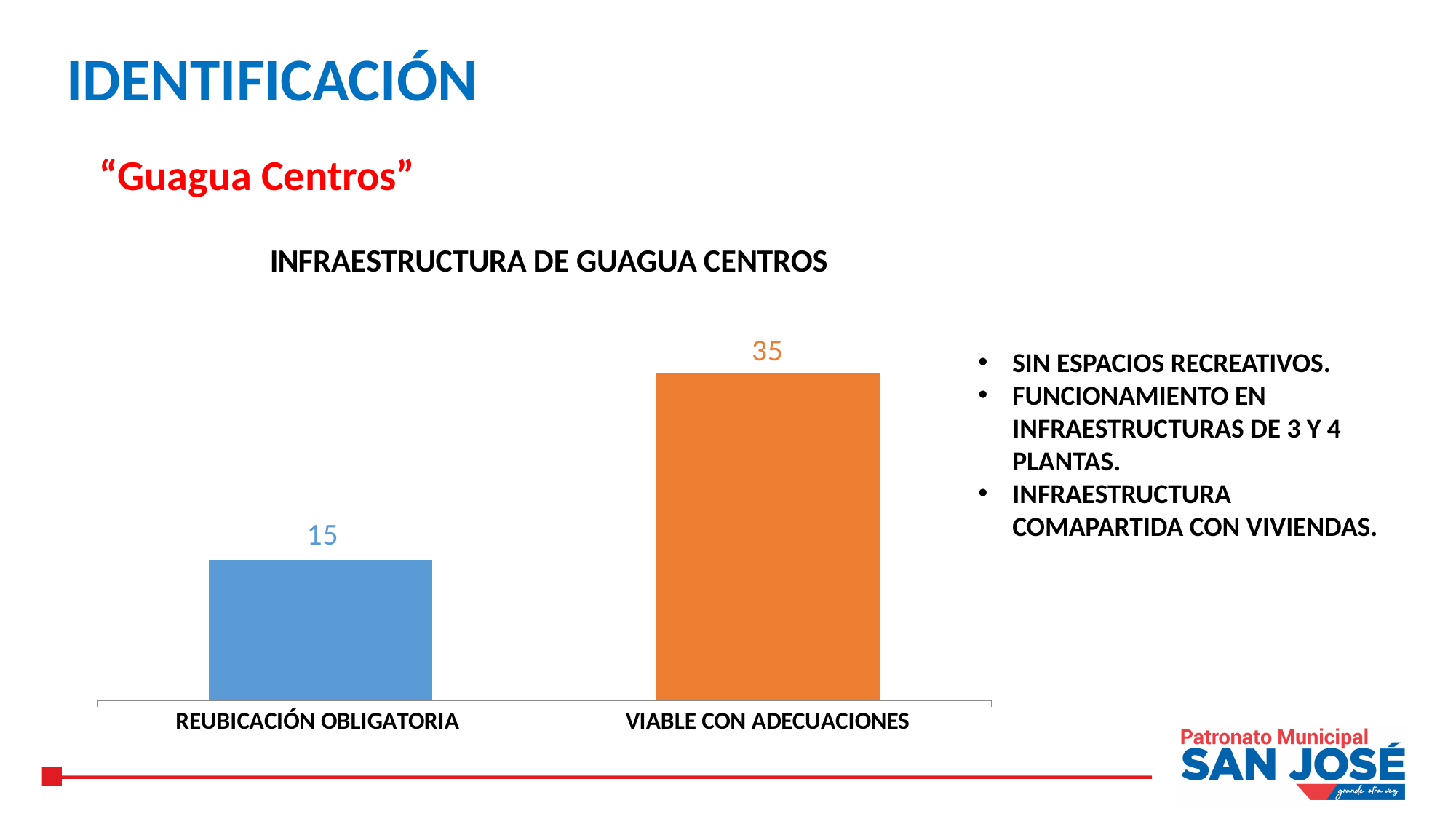
What is the total of the two values shown in the chart? 50 What is the value for REUBICACIÓN OBLIGATORIA? 15 What is the difference between the values for VIABLE CON ADECUACIONES and REUBICACIÓN OBLIGATORIA? 20 Which category has the lowest value? REUBICACIÓN OBLIGATORIA What is the value for VIABLE CON ADECUACIONES? 35 What colour is the bar for VIABLE CON ADECUACIONES? Orange How many categories are shown in the chart? 2 What is the title of the chart? INFRAESTRUCTURA DE GUAGUA CENTROS What kind of chart is shown on the slide? Bar chart Which is larger, the value for REUBICACIÓN OBLIGATORIA or the value for VIABLE CON ADECUACIONES? VIABLE CON ADECUACIONES Which category has the highest value? VIABLE CON ADECUACIONES